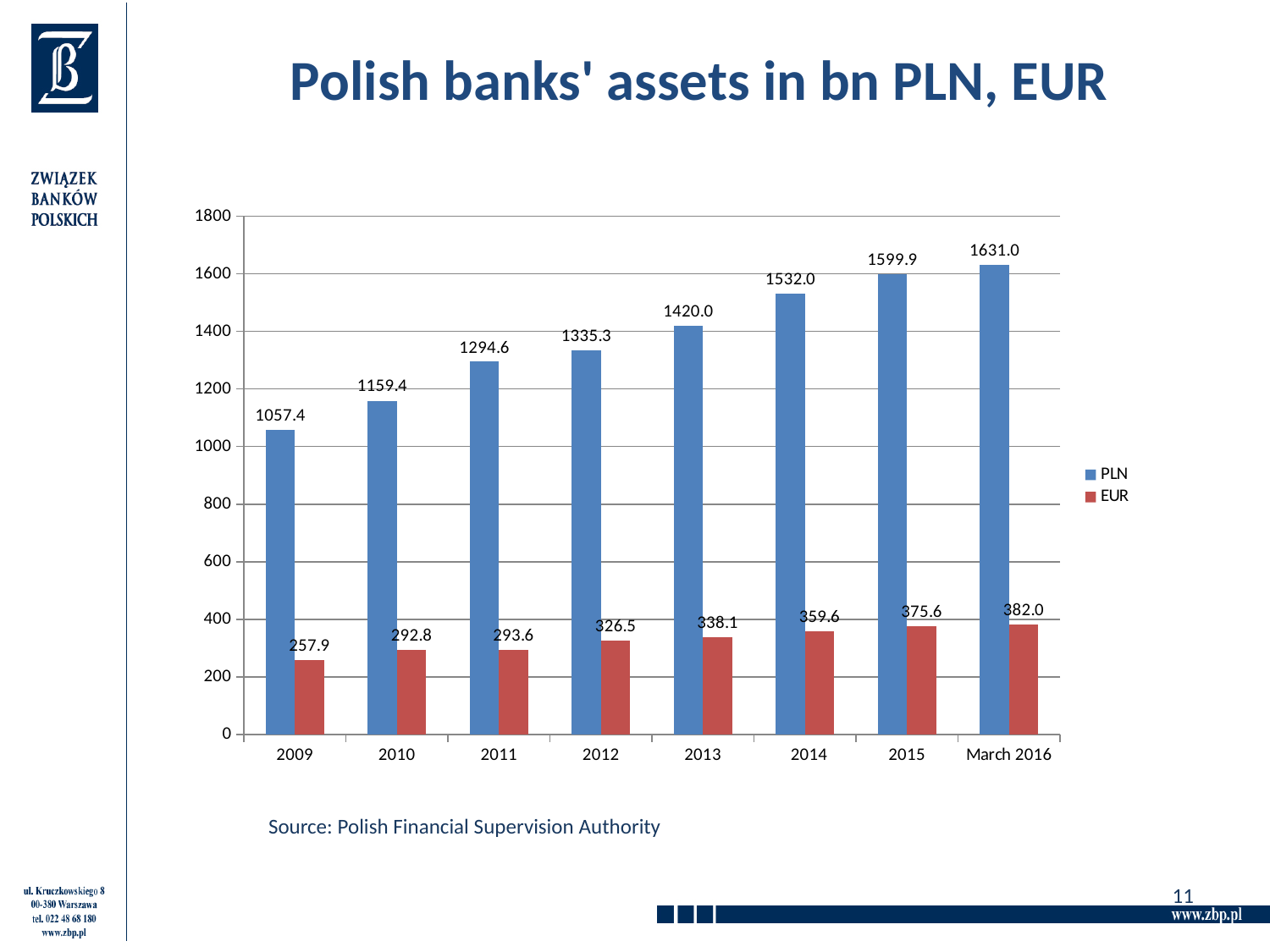
Is the PLN value for 2010 greater or less than 1200? less How many series does the legend list? 2 Do the PLN values rise or fall from 2009 to March 2016? rise What is the difference between the PLN values for 2015 and 2014? 67.9 What is the EUR value for March 2016? 382.0 What kind of chart is shown on the slide? bar chart Which category has the highest PLN value? March 2016 Which is larger, the EUR value for 2011 or the EUR value for 2012? 2012 How many categories are shown on the x axis? 8 What is the PLN value for 2013? 1420.0 Which category has the lowest EUR value? 2009 What is the EUR value for 2009? 257.9